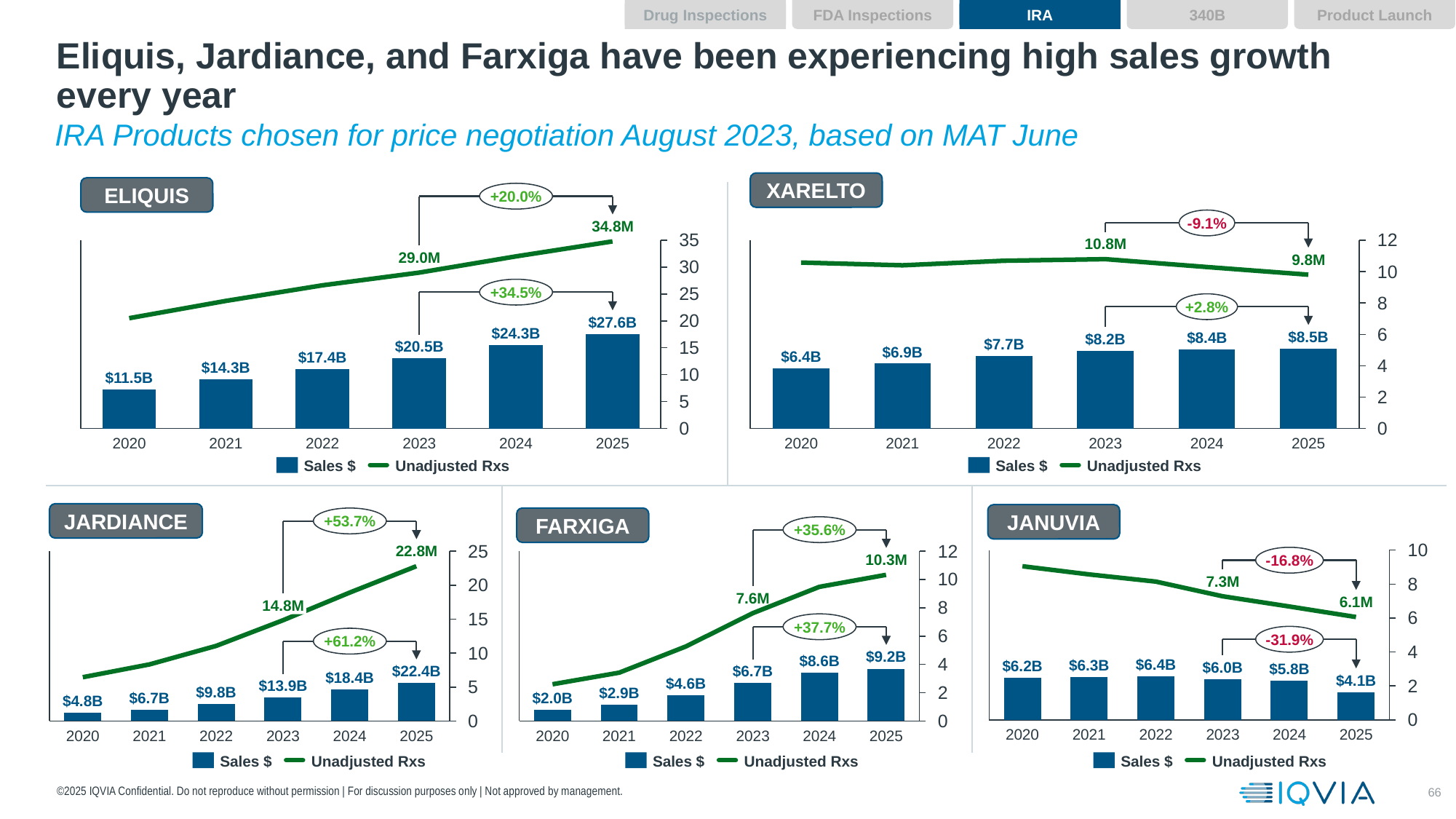
In the XARELTO chart, what is the Unadjusted Rxs value for 2025? 9.8M How many series does the legend of the XARELTO chart list? 2 In the JANUVIA chart, does the Unadjusted Rxs line rise or fall from 2020 to 2025? Fall In the ELIQUIS chart, what percentage growth is shown for Sales $ between 2023 and 2025? +34.5% In the JANUVIA chart, is the Unadjusted Rxs value for 2020 greater or less than 10? less In the ELIQUIS chart, what is the Sales $ value for 2025? $27.6B How many years are shown on the x axis of the ELIQUIS chart? 6 In the FARXIGA chart, which year has the highest Sales $ value? 2025 In the JARDIANCE chart, what is the difference between the Sales $ values for 2025 and 2020? $17.6B Which is larger: the 2020 Sales $ value in the ELIQUIS chart or the 2020 Sales $ value in the XARELTO chart? ELIQUIS ($11.5B) What kind of chart is the FARXIGA chart? Combination bar and line chart In the JANUVIA chart, which year has the lowest Sales $ value? 2025